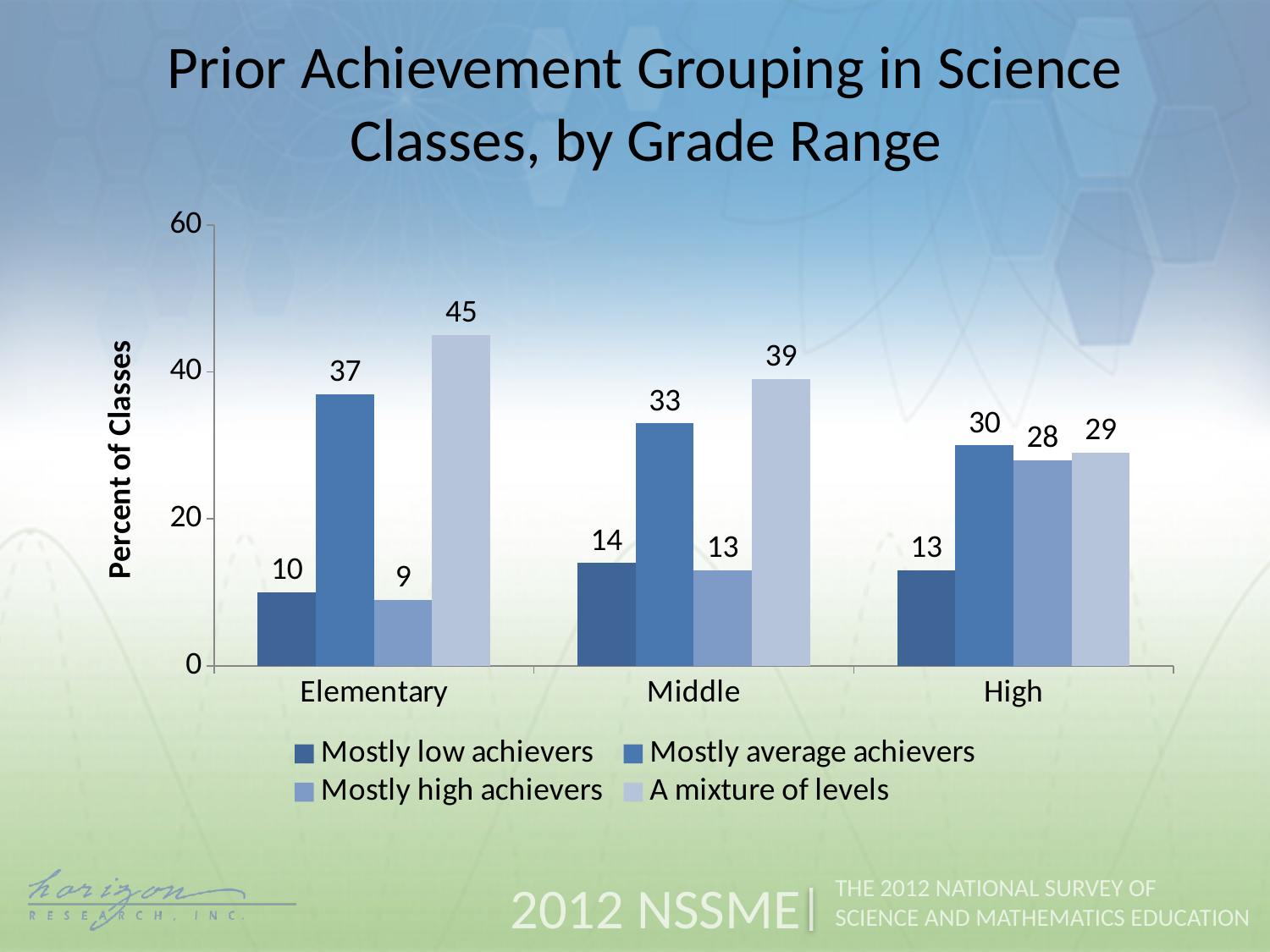
How many grade ranges are shown on the x axis? 3 What is the value for Mostly high achievers in High classes? 28 What kind of chart is shown on the slide? bar chart Which grade range has the lowest value for Mostly high achievers? Elementary What is the difference between the A mixture of levels values for Elementary and High? 16 What is the value for Mostly average achievers in Middle classes? 33 Which grade range has the highest value for Mostly low achievers? Middle What is the label of the y axis? Percent of Classes Is the value for A mixture of levels in Middle greater or less than 40? less Which is larger: Mostly average achievers in Elementary or Mostly average achievers in High? Elementary How many series does the legend list? 4 What percent of Elementary classes are grouped as a mixture of levels? 45